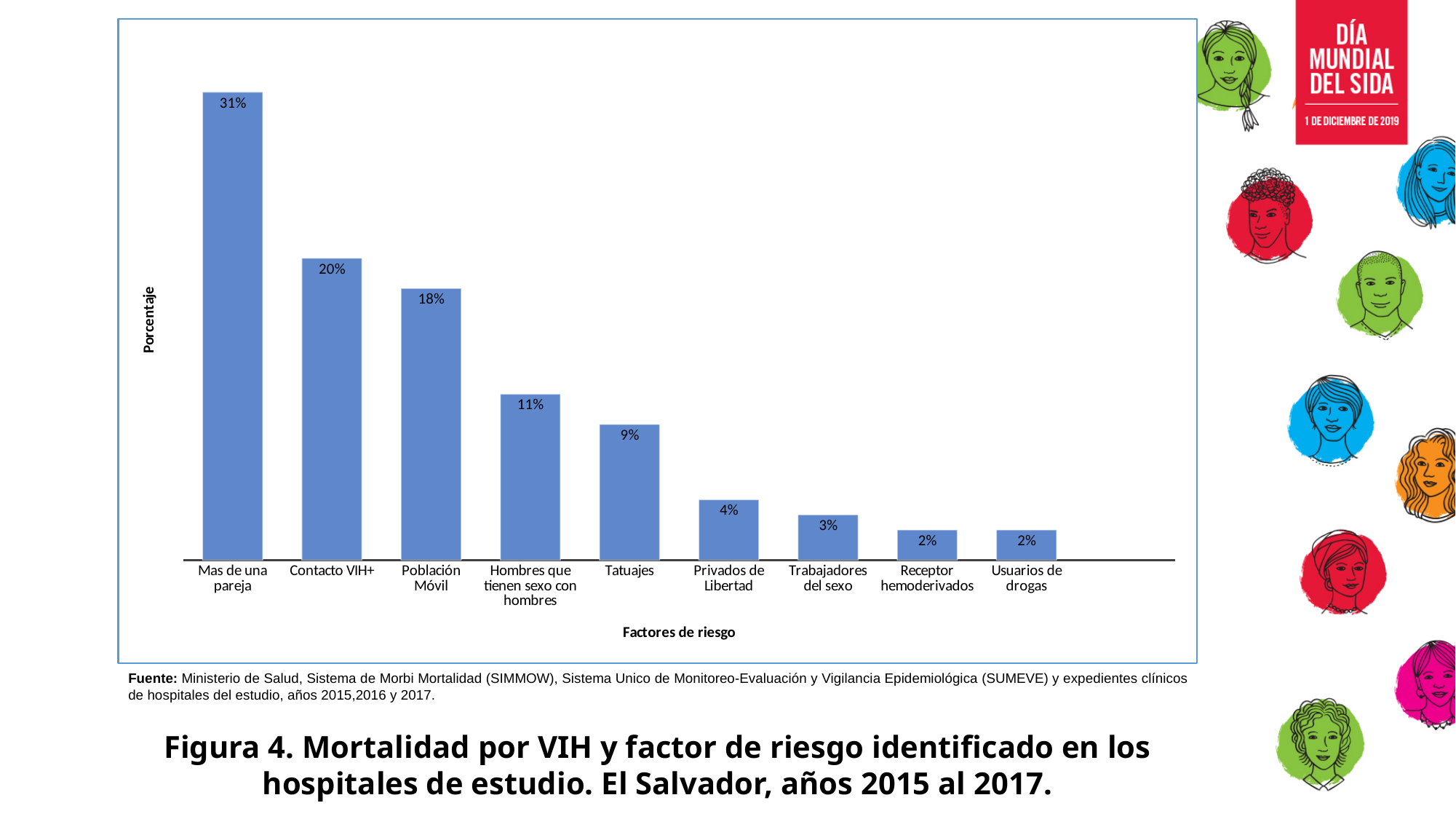
What is the value for "Hombres que tienen sexo con hombres"? 11% What is the value for "Tatuajes"? 9% What kind of chart is shown on the slide? Bar chart Which risk factor has the highest value? Mas de una pareja Which is larger, the value for "Población Móvil" or the value for "Tatuajes"? Población Móvil What is the difference between the values for "Población Móvil" and "Privados de Libertad"? 14% What is the value for "Trabajadores del sexo"? 3% What is the value for "Contacto VIH+"? 20% What is the value for "Mas de una pareja"? 31% How many risk factor categories are shown in the chart? 9 What is the label of the x axis of the chart? Factores de riesgo What is the difference between the values for "Mas de una pareja" and "Contacto VIH+"? 11%